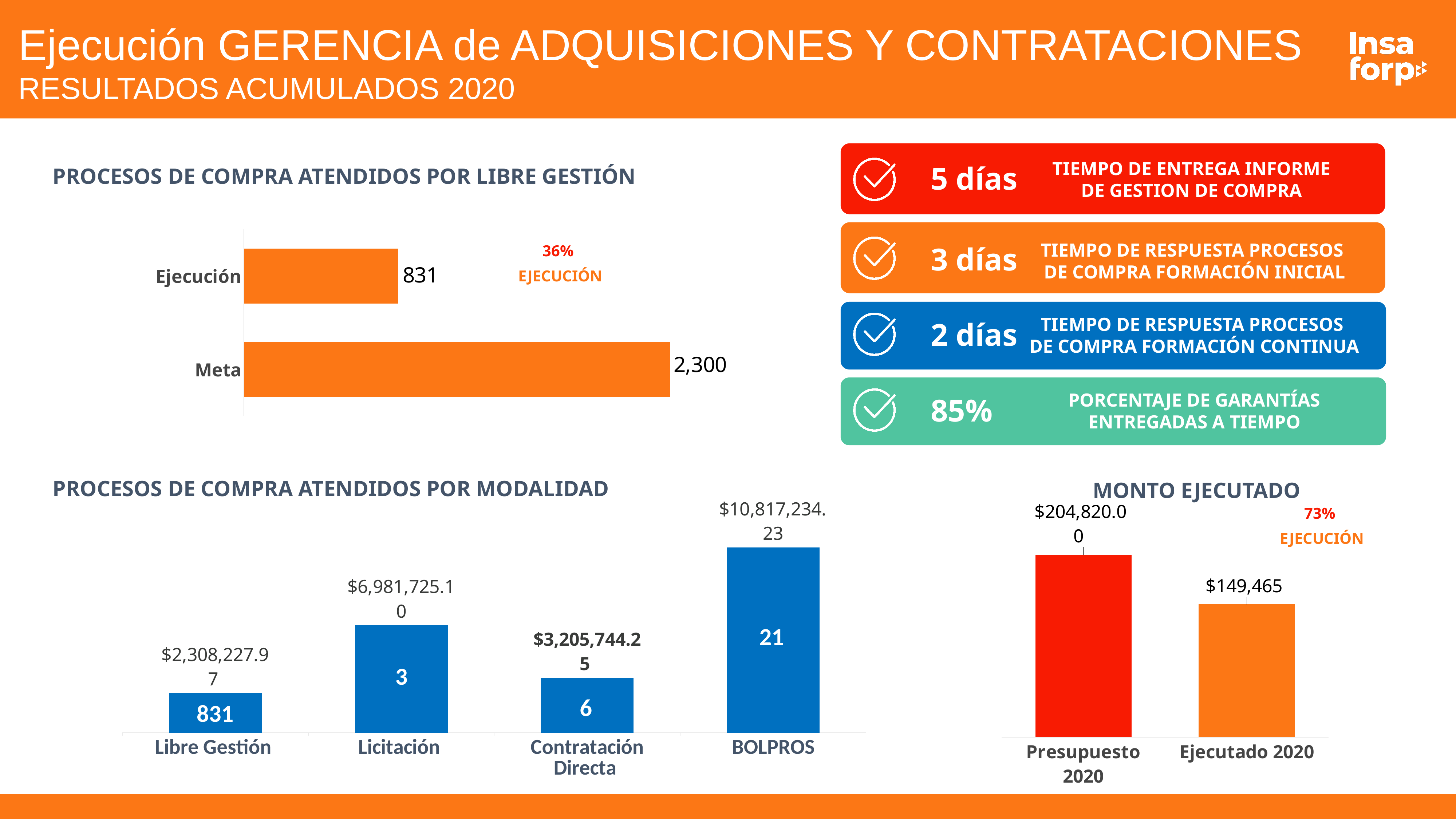
In the chart 'PROCESOS DE COMPRA ATENDIDOS POR MODALIDAD', which category has the shortest bar? Libre Gestión In the chart 'PROCESOS DE COMPRA ATENDIDOS POR LIBRE GESTIÓN', what is the difference between Meta and Ejecución? 1,469 In the chart 'PROCESOS DE COMPRA ATENDIDOS POR MODALIDAD', what number is printed inside the Contratación Directa bar? 6 In the chart 'MONTO EJECUTADO', what is the value for Ejecutado 2020? $149,465 In the chart 'PROCESOS DE COMPRA ATENDIDOS POR MODALIDAD', what is the dollar amount shown for Licitación? $6,981,725.10 In the chart 'MONTO EJECUTADO', which is larger, Presupuesto 2020 or Ejecutado 2020? Presupuesto 2020 How many categories are shown in the chart 'PROCESOS DE COMPRA ATENDIDOS POR MODALIDAD'? 4 What kind of chart is 'PROCESOS DE COMPRA ATENDIDOS POR LIBRE GESTIÓN'? Bar chart In the chart 'PROCESOS DE COMPRA ATENDIDOS POR MODALIDAD', what is the dollar amount shown for BOLPROS? $10,817,234.23 In the chart 'PROCESOS DE COMPRA ATENDIDOS POR LIBRE GESTIÓN', what is the value for Ejecución? 831 In the chart 'PROCESOS DE COMPRA ATENDIDOS POR MODALIDAD', which category has the tallest bar? BOLPROS In the chart 'PROCESOS DE COMPRA ATENDIDOS POR LIBRE GESTIÓN', what is the value for Meta? 2,300